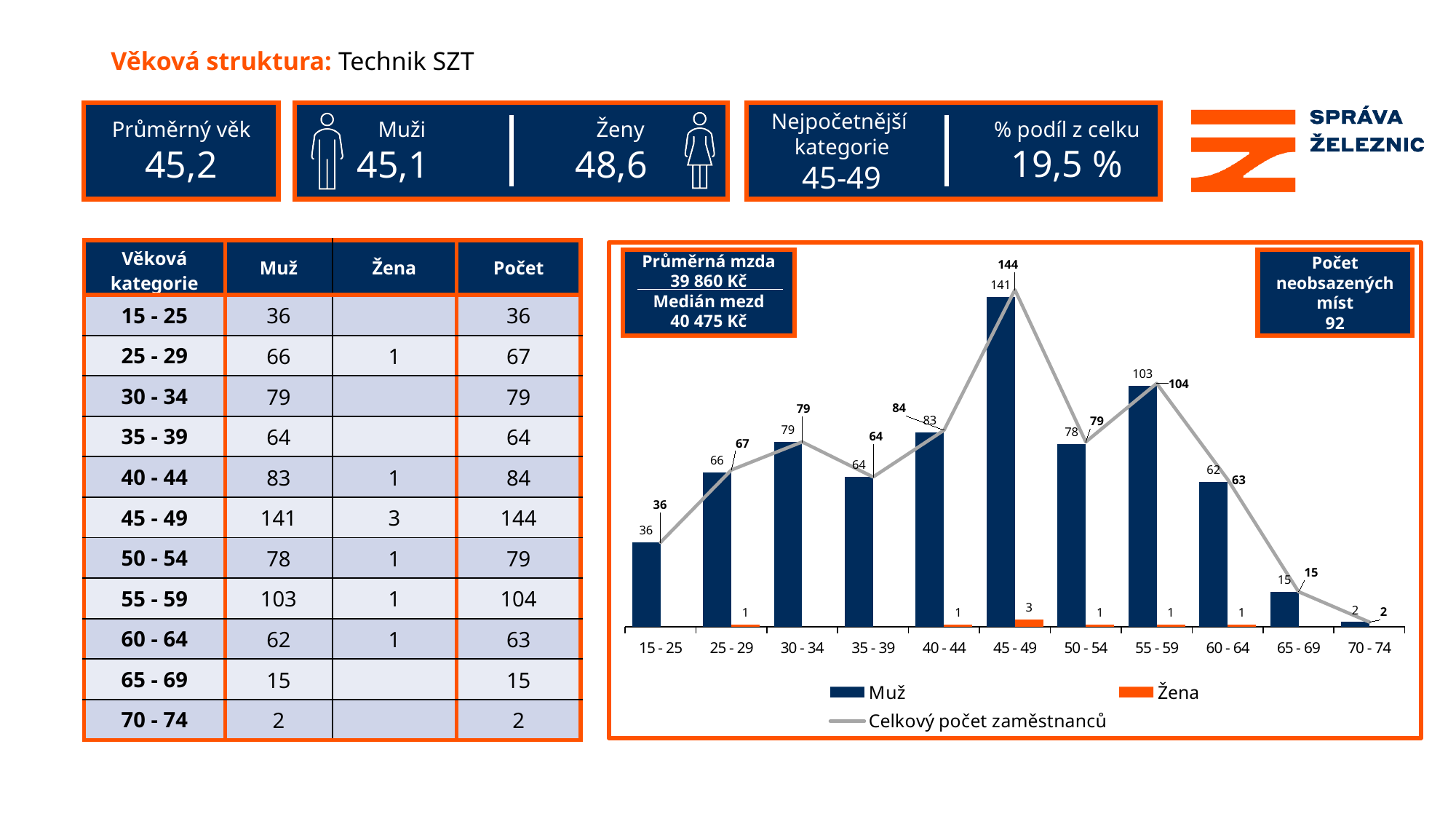
Which age category has the lowest Celkový počet zaměstnanců value? 70 - 74 What colour are the Žena bars in the chart? orange What is the value of the Celkový počet zaměstnanců line for the 55 - 59 age category? 104 Which is larger, the Muž value for 30 - 34 or for 50 - 54? 30 - 34 What is the value of the Muž series for the 45 - 49 age category in the chart? 141 What is the difference between the Muž values for 45 - 49 and 55 - 59? 38 How many age categories are shown on the x axis of the chart? 11 Does the Celkový počet zaměstnanců line rise or fall from 45 - 49 to 70 - 74? fall What kind of chart is used to show the Muž and Žena series? bar chart How many series does the chart legend list? 3 Which age category has the highest Muž value in the chart? 45 - 49 What is the value of the Žena series for the 45 - 49 age category? 3